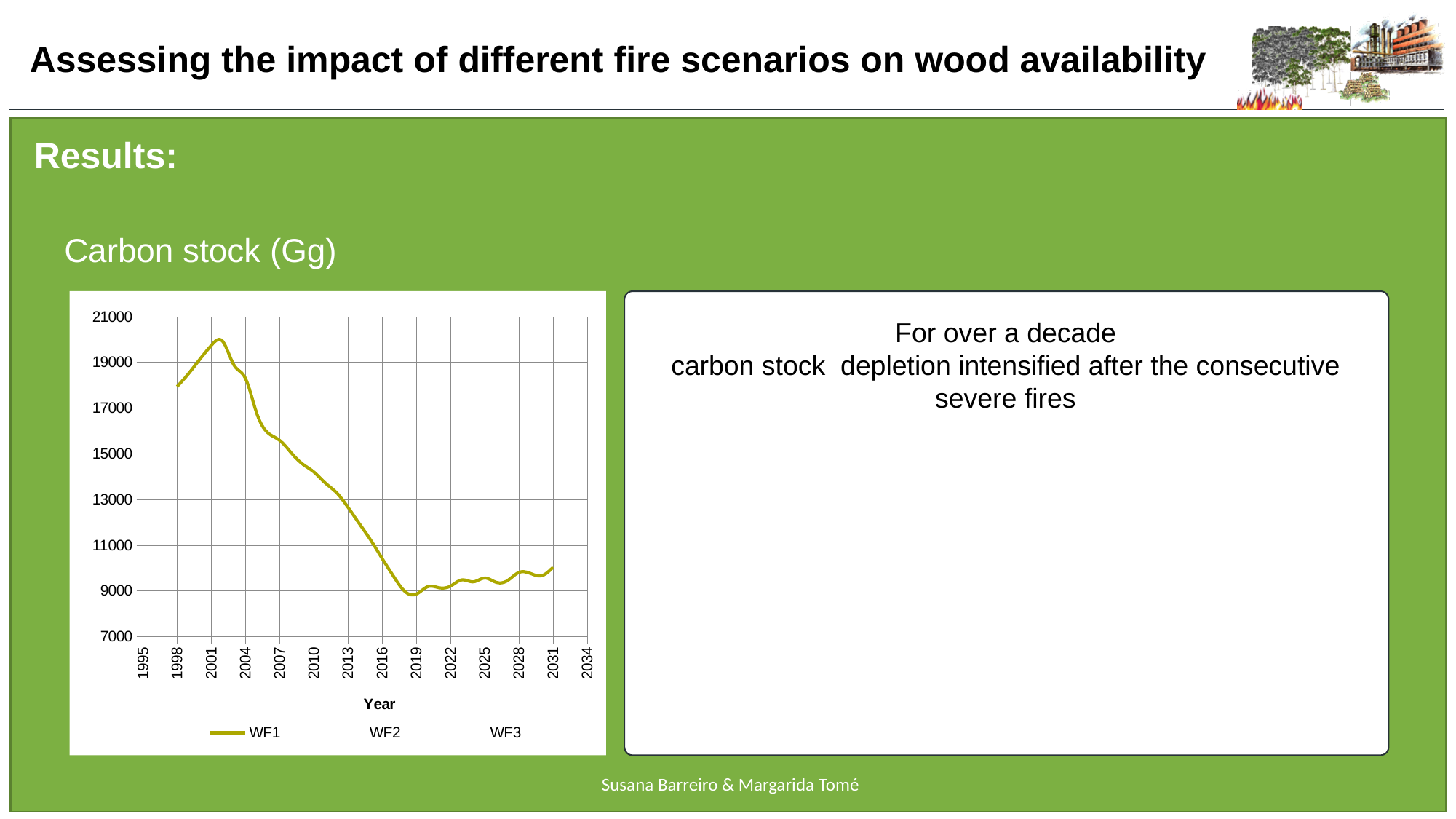
What kind of chart is shown on the slide? line chart Is the WF1 value for 2007 greater or less than 15000? greater Is the WF1 value for 2004 greater or less than 17000? greater How many series does the chart's legend list? 3 What is the title of the chart's x axis? Year Is the WF1 value for 2025 greater or less than 11000? less Which is larger, the WF1 value for 2001 or the WF1 value for 2016? 2001 Does the WF1 line rise or fall between 2004 and 2019? fall What are the series names listed in the chart's legend? WF1, WF2, WF3